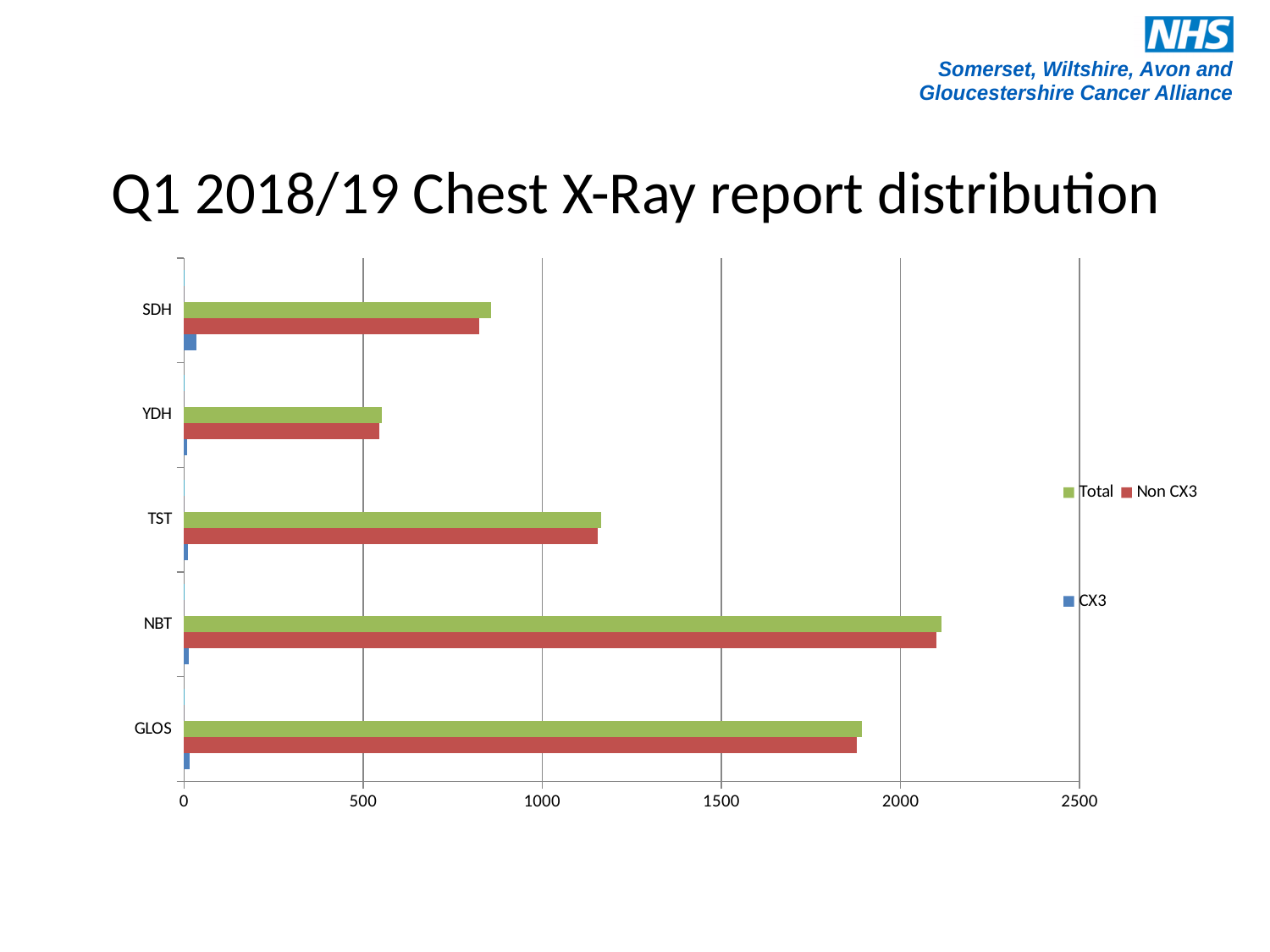
Which site has the highest Total value? NBT What is the title of the chart? Q1 2018/19 Chest X-Ray report distribution Which site has the larger Total value, NBT or GLOS? NBT Which site has the lowest Total value? YDH Which series is shown in green? Total Is the Total value for TST greater or less than 1000? greater Is the Non CX3 value for SDH greater or less than 1000? less What kind of chart is shown on the slide? bar chart Is the Total value for NBT greater or less than 2000? greater How many series does the legend list? 3 How many categories (sites) are shown on the chart? 5